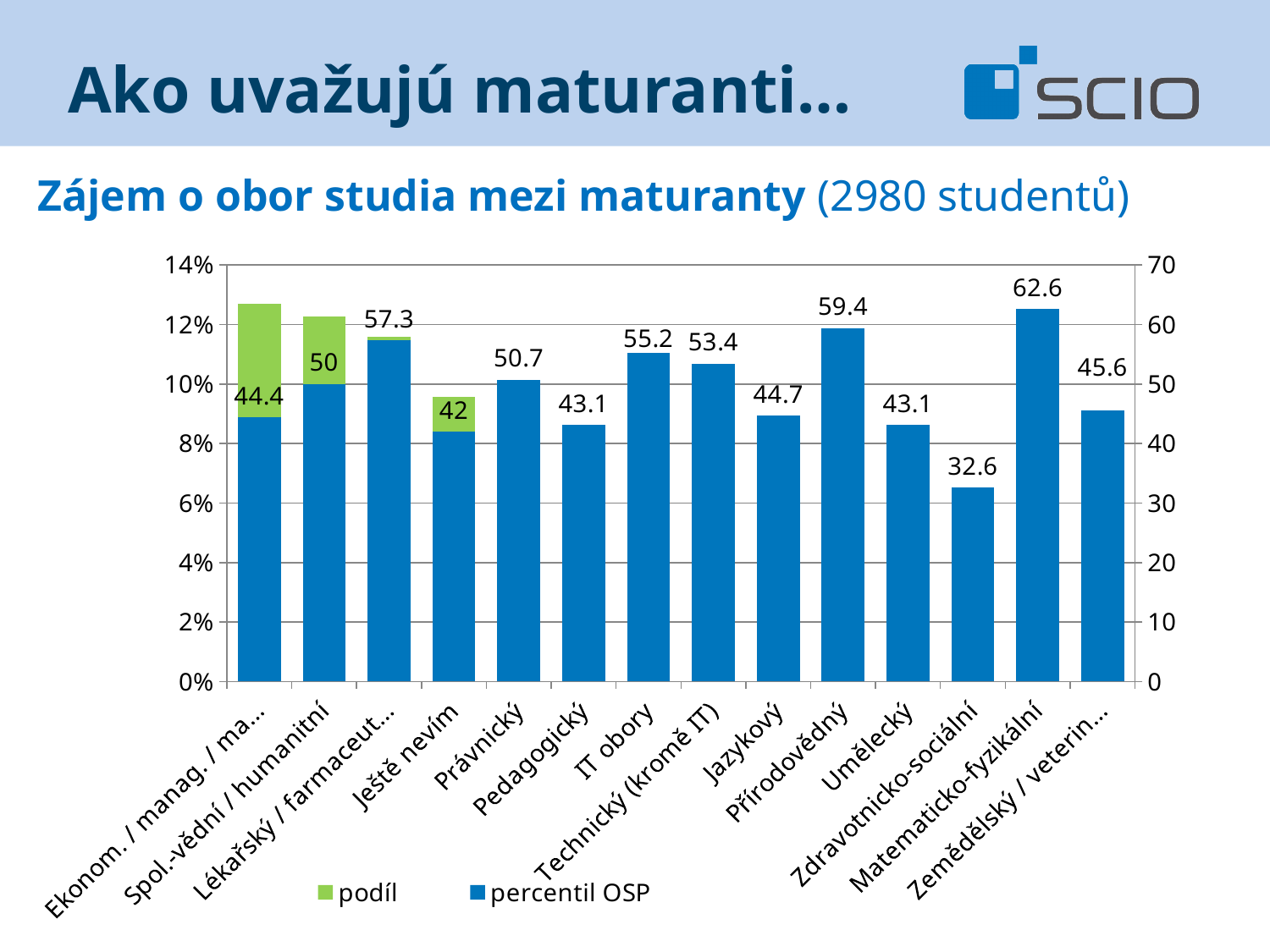
What is the difference in percentil OSP between Matematicko-fyzikální and Zdravotnicko-sociální? 30 What is the percentil OSP value for Zdravotnicko-sociální? 32.6 Which category has the lowest percentil OSP? Zdravotnicko-sociální What is the percentil OSP value for Matematicko-fyzikální? 62.6 What is the percentil OSP value for Ještě nevím? 42 How many series does the legend list? 2 What is the percentil OSP value for Přírodovědný? 59.4 Which category has the highest percentil OSP? Matematicko-fyzikální Is the podíl value for Ekonom. / manag. / ma... greater or less than 12%? greater What kind of chart is shown on the slide? bar chart Which has a higher percentil OSP, IT obory or Technický (kromě IT)? IT obory How many categories are shown on the x axis? 14